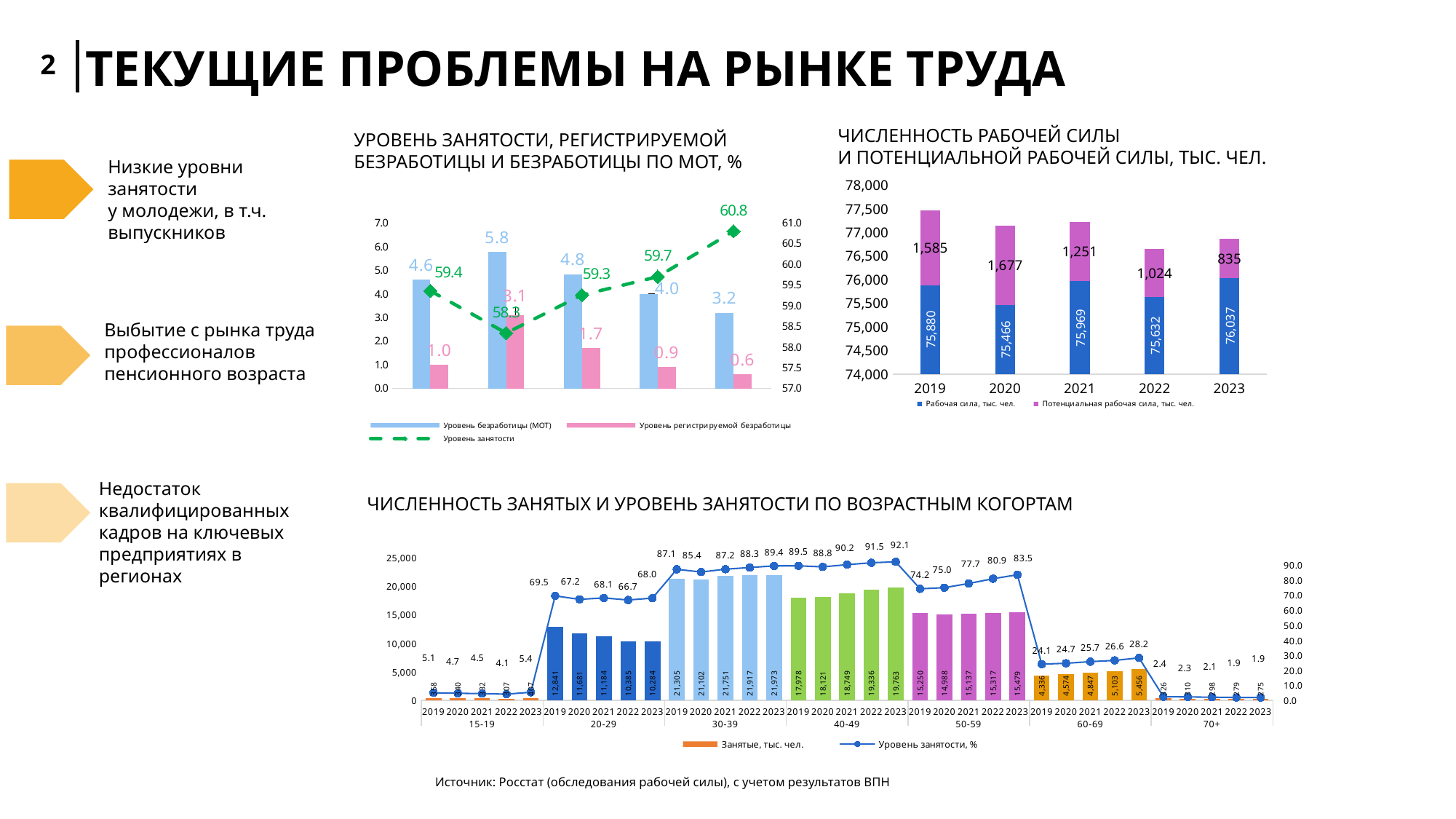
On the chart 'Численность занятых и уровень занятости по возрастным когортам', what is the Уровень занятости for the 40-49 cohort in 2023? 92.1 On the chart 'Численность рабочей силы и потенциальной рабочей силы, тыс. чел.', which year has the lowest Потенциальная рабочая сила? 2023 On the chart 'Численность занятых и уровень занятости по возрастным когортам', how many age cohorts are shown on the x axis? 7 On the chart 'Численность рабочей силы и потенциальной рабочей силы, тыс. чел.', what is the total height of the stacked bar for 2019? 77,465 On the chart 'Уровень занятости, регистрируемой безработицы и безработицы по МОТ, %', what is the highest value of Уровень безработицы (МОТ)? 5.8 On the chart 'Численность рабочей силы и потенциальной рабочей силы, тыс. чел.', what is the difference between Рабочая сила in 2023 and in 2022? 405 On the chart 'Уровень занятости, регистрируемой безработицы и безработицы по МОТ, %', what is the highest value of Уровень занятости? 60.8 On the chart 'Уровень занятости, регистрируемой безработицы и безработицы по МОТ, %', how many series does the legend list? 3 On the chart 'Численность занятых и уровень занятости по возрастным когортам', what is the number of Занятые for the 30-39 cohort in 2023? 21,973 On the chart 'Численность рабочей силы и потенциальной рабочей силы, тыс. чел.', what is the value of Рабочая сила for 2023? 76,037 On the chart 'Численность рабочей силы и потенциальной рабочей силы, тыс. чел.', what is the value of Потенциальная рабочая сила for 2020? 1,677 On the chart 'Численность занятых и уровень занятости по возрастным когортам', does the Уровень занятости for the 50-59 cohort rise or fall from 2019 to 2023? rise